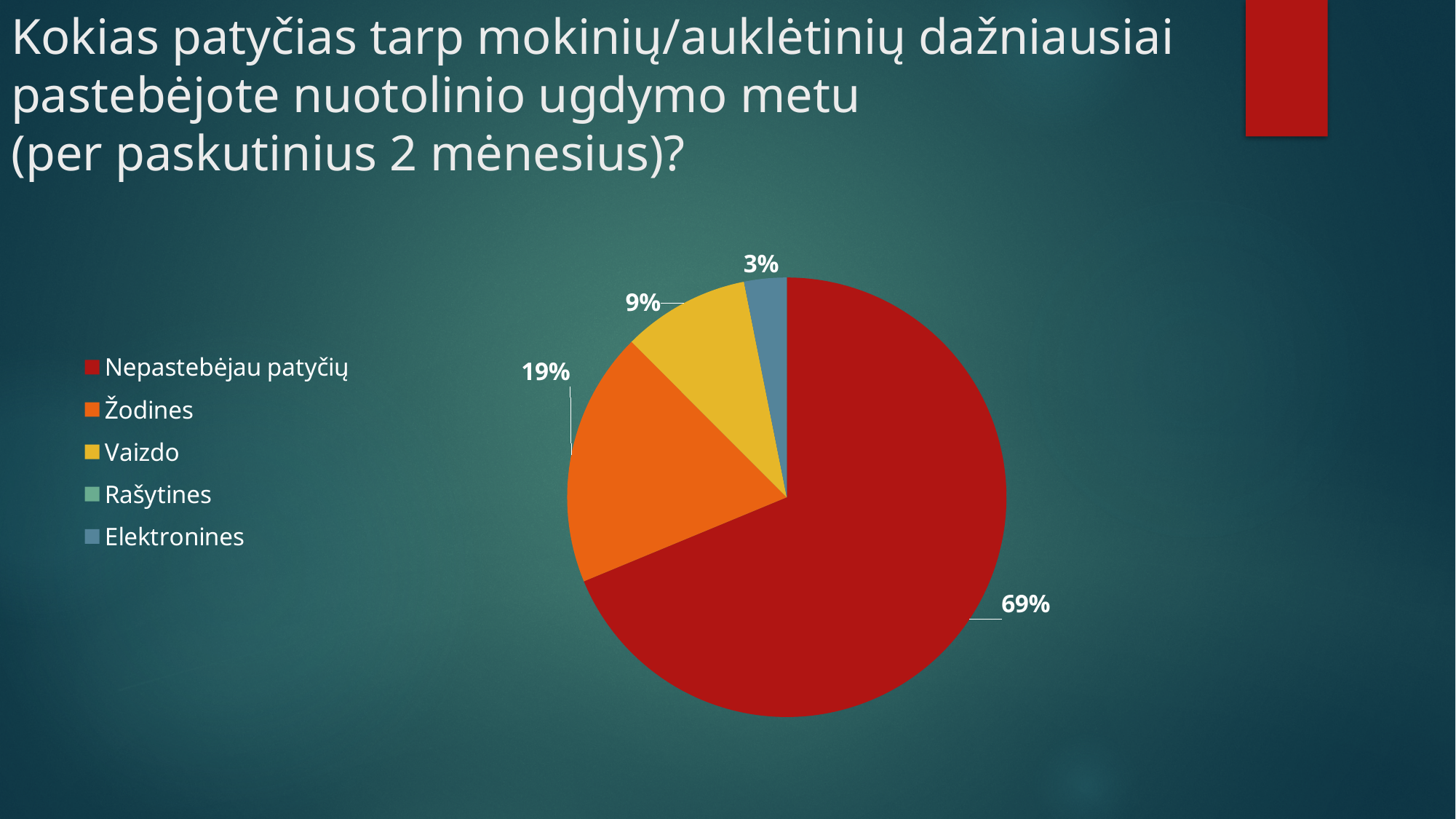
What is the value shown for "Žodines"? 19% What share of the pie does "Nepastebėjau patyčių" take? 69% Which category has the largest slice of the pie? Nepastebėjau patyčių Which of the labelled slices is the smallest? Elektronines Which is larger, the share for "Vaizdo" or the share for "Elektronines"? Vaizdo How many entries does the legend list? 5 What is the value shown for "Vaizdo"? 9% What is the difference between the shares for "Žodines" and "Vaizdo"? 10% What colour is the slice for "Žodines"? orange What is the difference between the shares for "Nepastebėjau patyčių" and "Žodines"? 50% What is the value shown for "Elektronines"? 3% What kind of chart is shown on the slide? pie chart